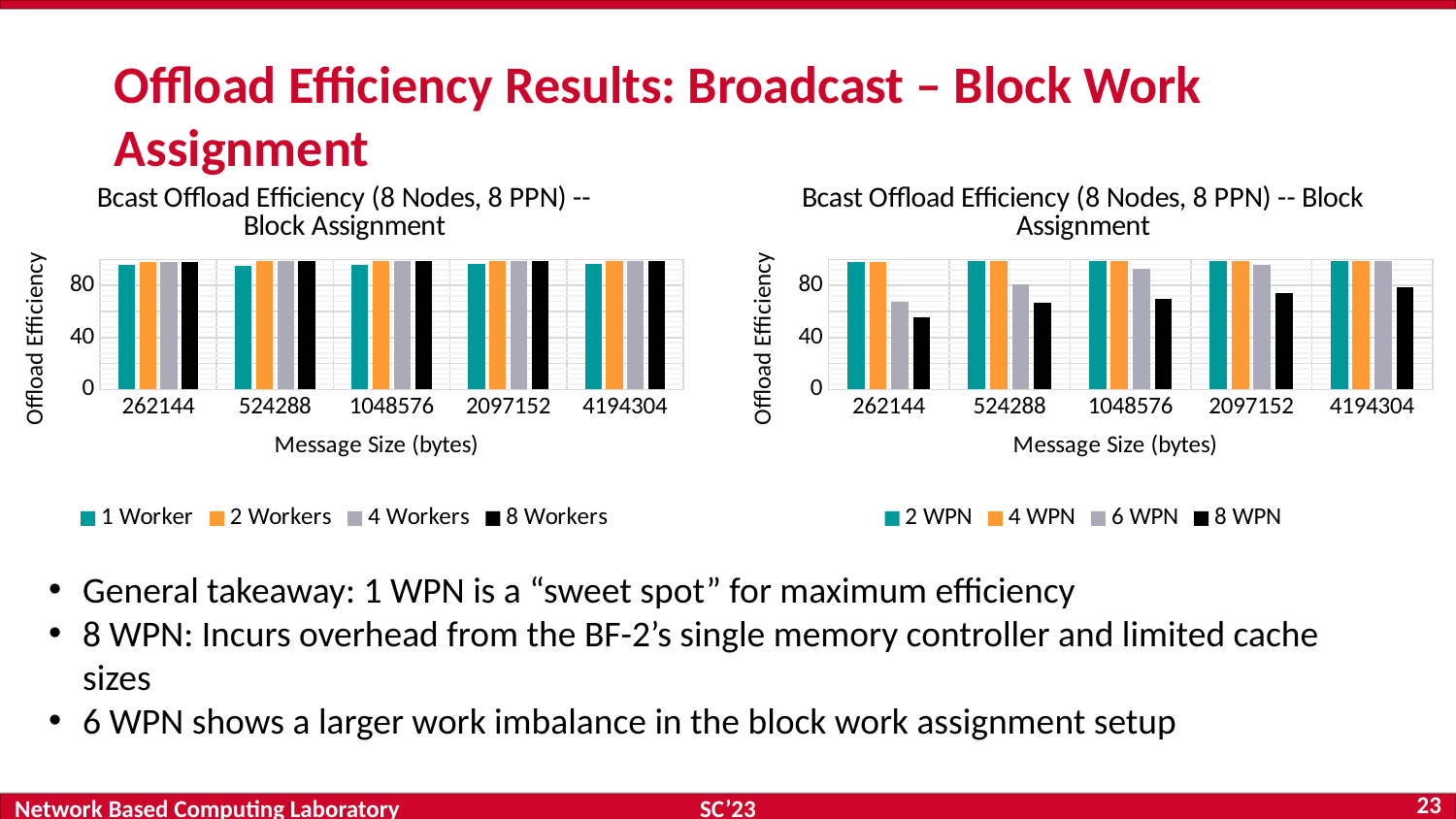
What kind of chart is the left chart on the slide? bar chart In the right chart, is the value for 8 WPN at message size 262144 greater or less than 80? less How many message size categories are shown on the x axis of the right chart? 5 What is the x-axis title of the left chart? Message Size (bytes) How many series does the legend of the left chart list? 4 How many series does the legend of the right chart list? 4 In the right chart, do the values for 8 WPN rise or fall as message size increases along the x axis? rise In the right chart, at message size 262144, which is larger: the value for 2 WPN or the value for 8 WPN? 2 WPN In the right chart, which series has the lowest value at message size 262144? 8 WPN In the right chart, which series has the lowest value at message size 1048576? 8 WPN In the right chart, is the value for 8 WPN at message size 262144 greater or less than 40? greater In the right chart, is the value for 6 WPN at message size 262144 greater or less than 80? less